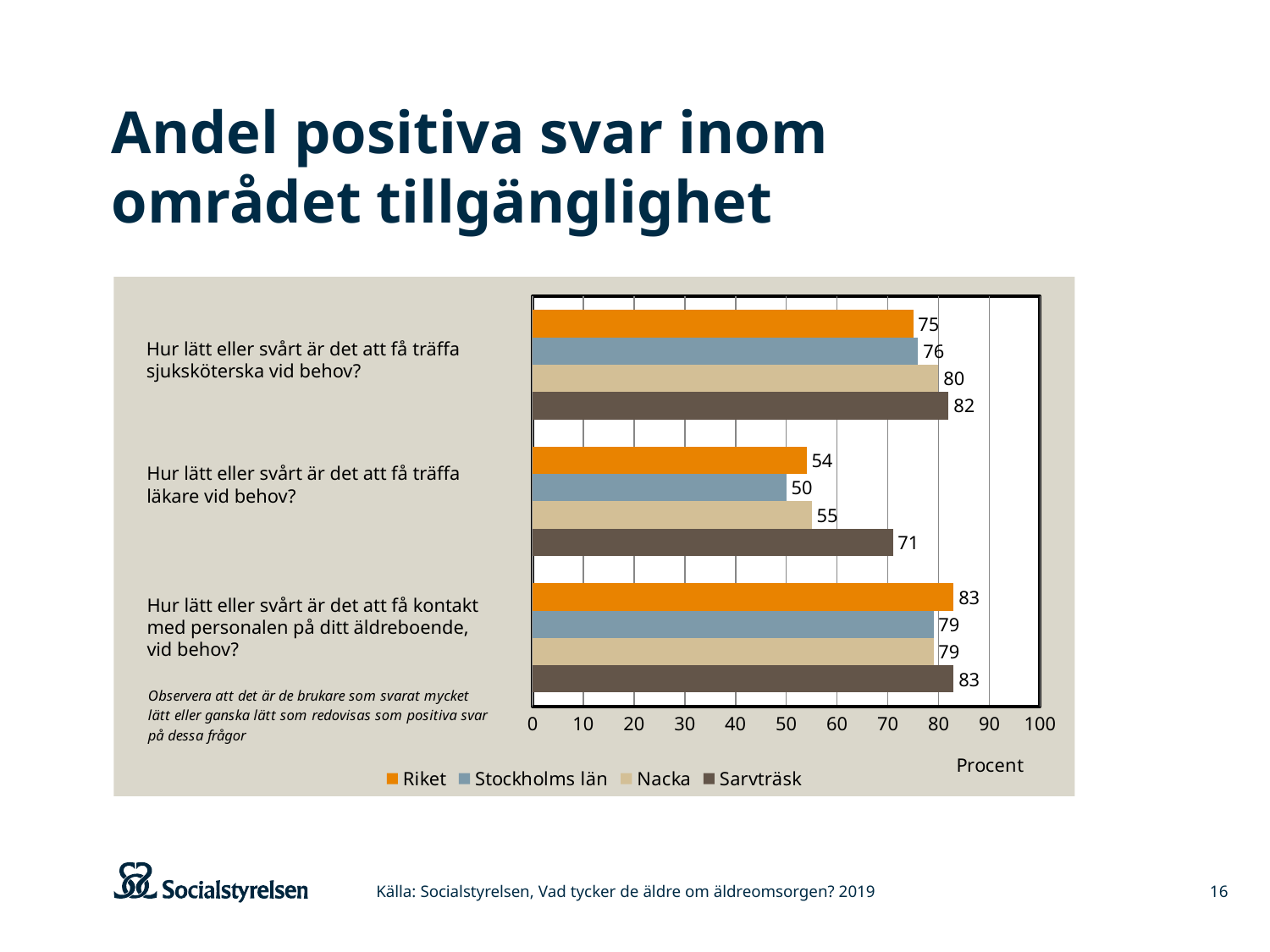
What is the value for Stockholms län on the question "Hur lätt eller svårt är det att få kontakt med personalen på ditt äldreboende, vid behov?"? 79 What is the value for Riket on the question "Hur lätt eller svårt är det att få träffa sjuksköterska vid behov?"? 75 Which series has the highest value on the question "Hur lätt eller svårt är det att få träffa sjuksköterska vid behov?"? Sarvträsk Which is larger on the question "Hur lätt eller svårt är det att få träffa sjuksköterska vid behov?": Nacka or Stockholms län? Nacka What is the label on the horizontal axis of the chart? Procent How many question categories are shown on the chart? 3 What kind of chart is shown on the slide? Bar chart Is the value for Nacka on the question "Hur lätt eller svårt är det att få träffa läkare vid behov?" greater or less than 60? less Which series has the lowest value on the question "Hur lätt eller svårt är det att få träffa läkare vid behov?"? Stockholms län How many series does the legend list? 4 What is the difference between Sarvträsk and Riket on the question "Hur lätt eller svårt är det att få träffa läkare vid behov?"? 17 What is the value for Sarvträsk on the question "Hur lätt eller svårt är det att få träffa läkare vid behov?"? 71